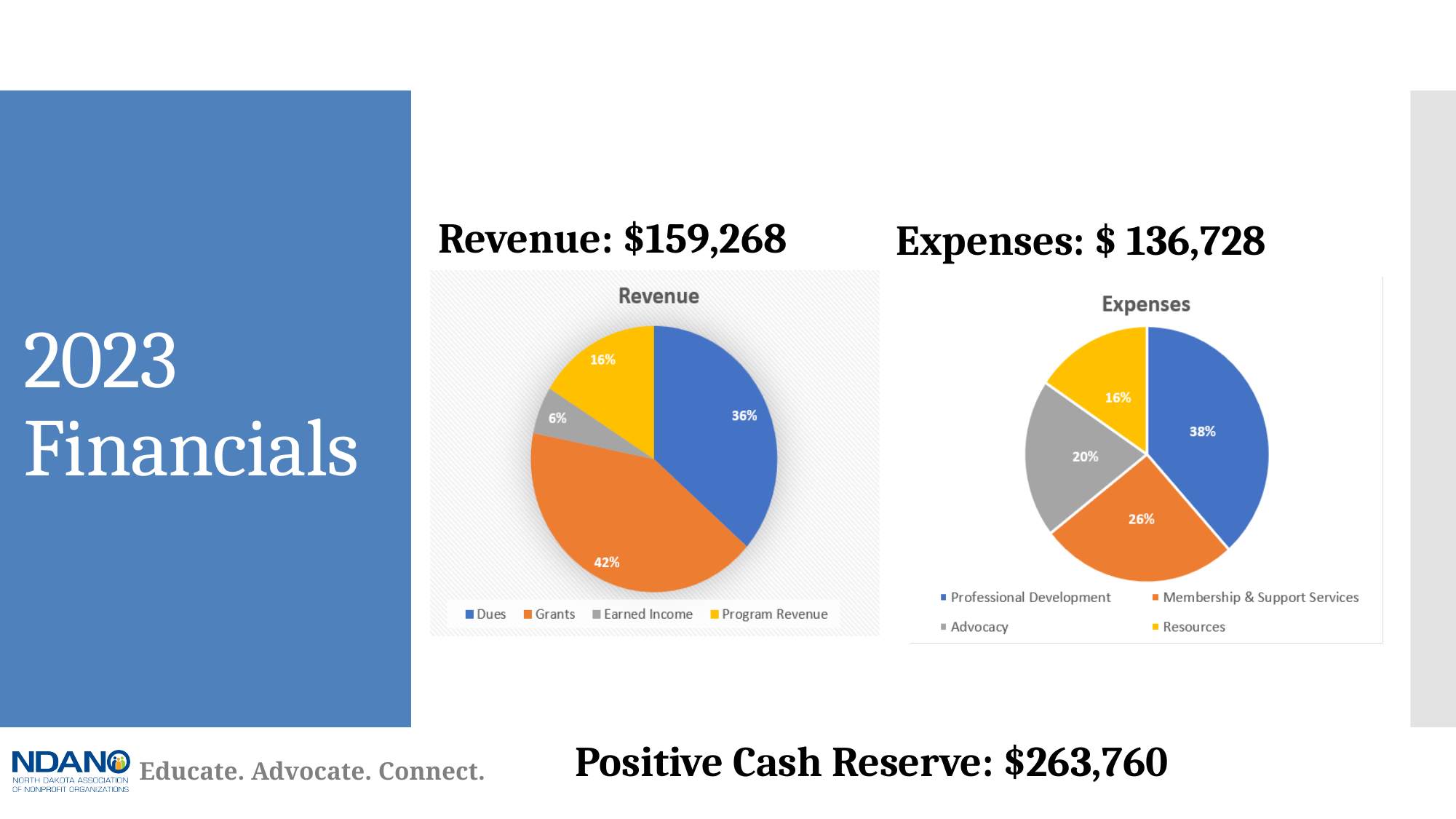
In the Expenses pie chart, what share does Advocacy account for? 20% In the Expenses pie chart, which category has the largest share? Professional Development In the Revenue pie chart, what share does Grants account for? 42% What type of chart is the Revenue chart? Pie chart In the Revenue pie chart, which category has the smallest share? Earned Income In the Revenue pie chart, what is the difference in percentage points between Grants and Program Revenue? 26 How many categories does the Expenses pie chart show? 4 In the Revenue pie chart, which category has the largest share? Grants In the Expenses pie chart, what share does Membership & Support Services account for? 26% In the Expenses pie chart, which is larger: Advocacy or Membership & Support Services? Membership & Support Services In the Revenue pie chart, what share does Dues account for? 36% In the Expenses pie chart, which category has the smallest share? Resources